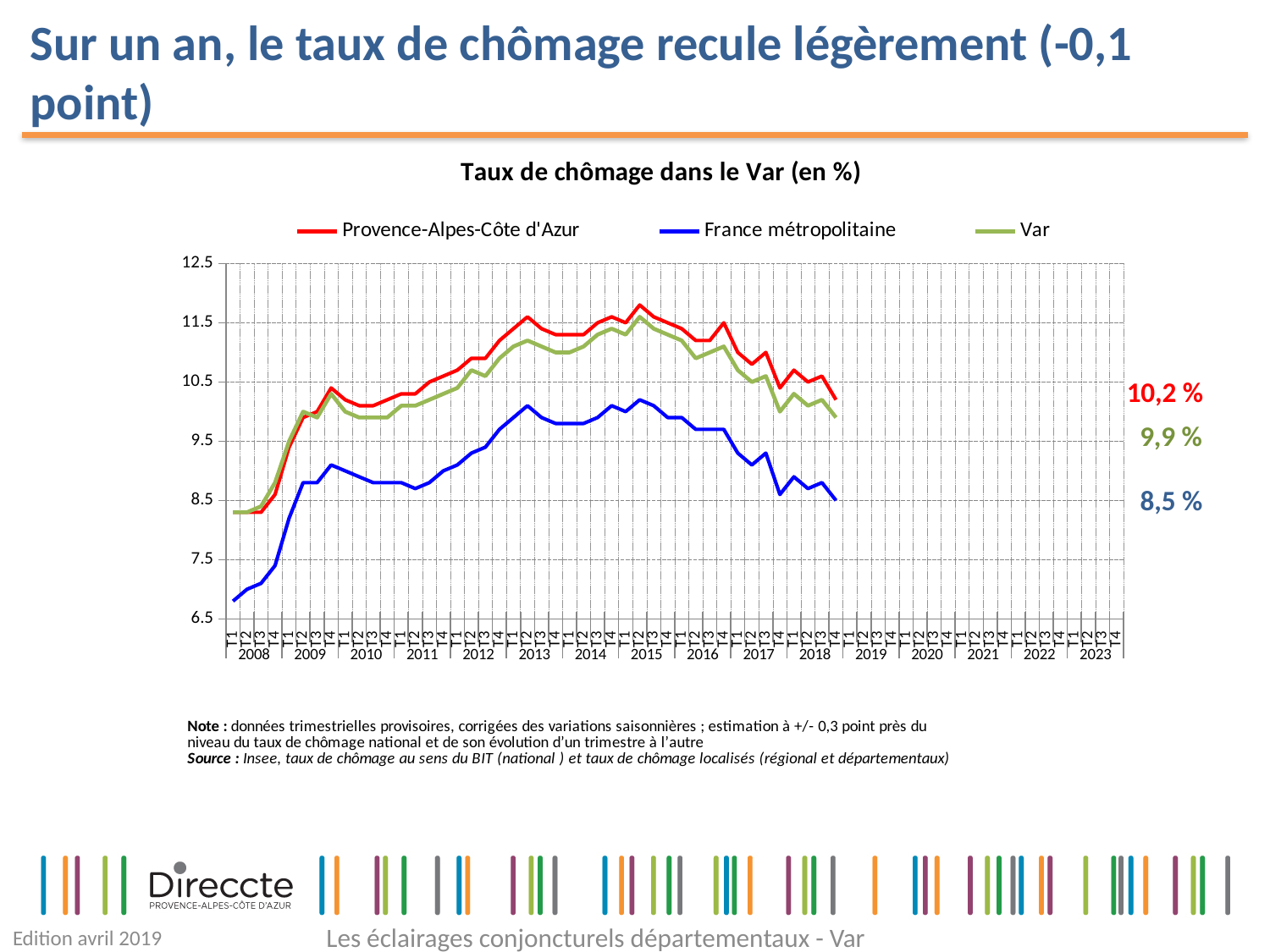
Does the France métropolitaine line rise or fall between 2008 and 2009? rise Which series has the highest value at the end of the plotted period? Provence-Alpes-Côte d'Azur What is the title of the chart? Taux de chômage dans le Var (en %) What is the difference between the latest values for Provence-Alpes-Côte d'Azur and France métropolitaine? 1,7 points Is the peak value for Provence-Alpes-Côte d'Azur in 2015 greater or less than 11.5? greater Is the value for France métropolitaine at T1 2008 greater or less than 7.5? less How many series does the legend list? 3 What is the latest value shown for Provence-Alpes-Côte d'Azur? 10,2 % What is the latest value shown for Var? 9,9 % What kind of chart is shown on the slide? line chart Which series has the lowest value at the end of the plotted period? France métropolitaine What is the latest value shown for France métropolitaine? 8,5 %